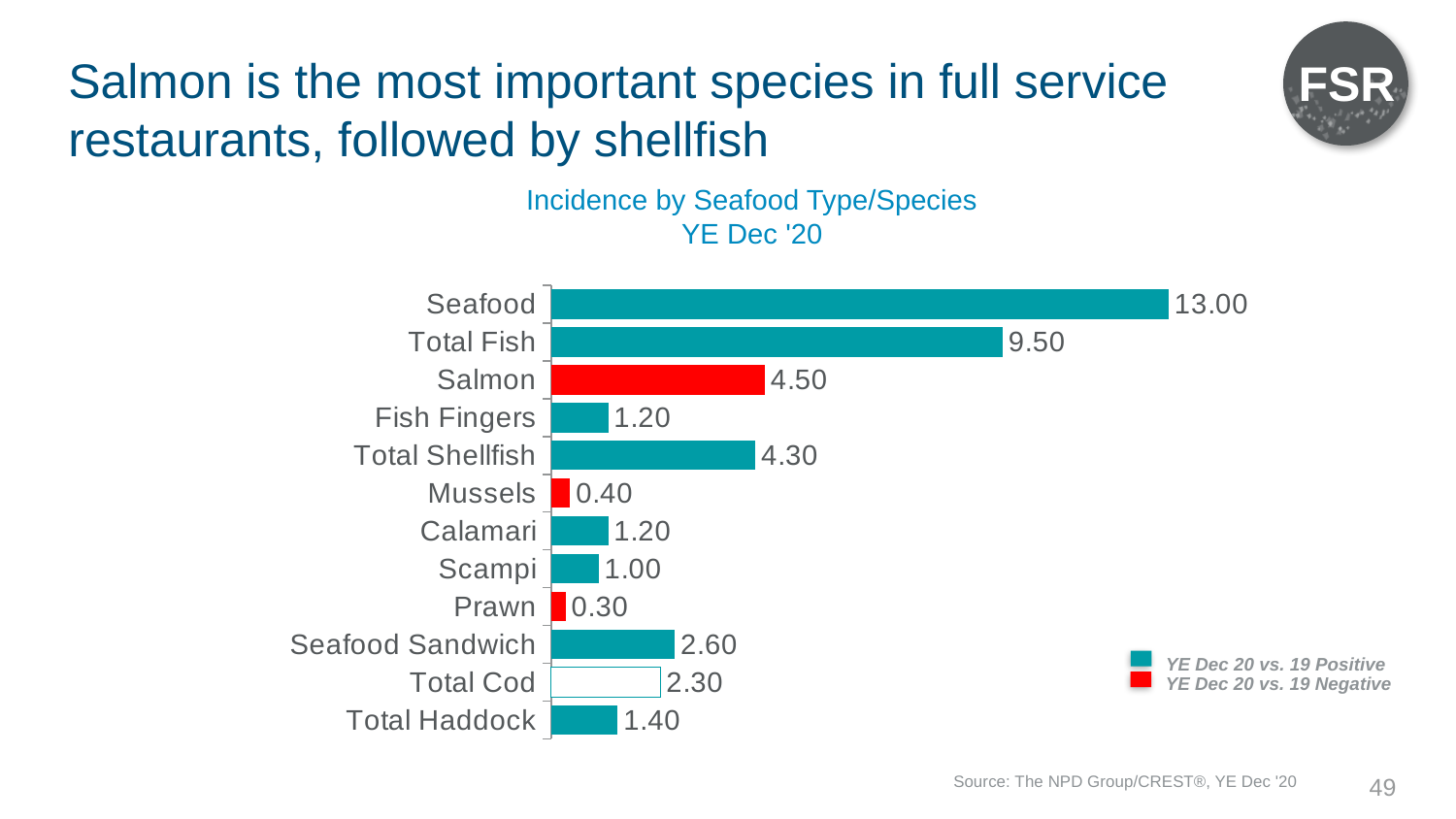
According to the legend, what does a red bar indicate? YE Dec 20 vs. 19 Negative What is the value for Total Cod? 2.30 What kind of chart is shown on the slide? Bar chart Which is larger, the value for Seafood Sandwich or the value for Total Haddock? Seafood Sandwich What is the difference between the values for Seafood and Total Fish? 3.50 What is the value for Seafood? 13.00 Which category has the highest value? Seafood What is the difference between the values for Salmon and Total Shellfish? 0.20 What is the title of the chart? Incidence by Seafood Type/Species YE Dec '20 What is the value for Total Shellfish? 4.30 Which category has the lowest value? Prawn How many categories are shown in the chart? 12